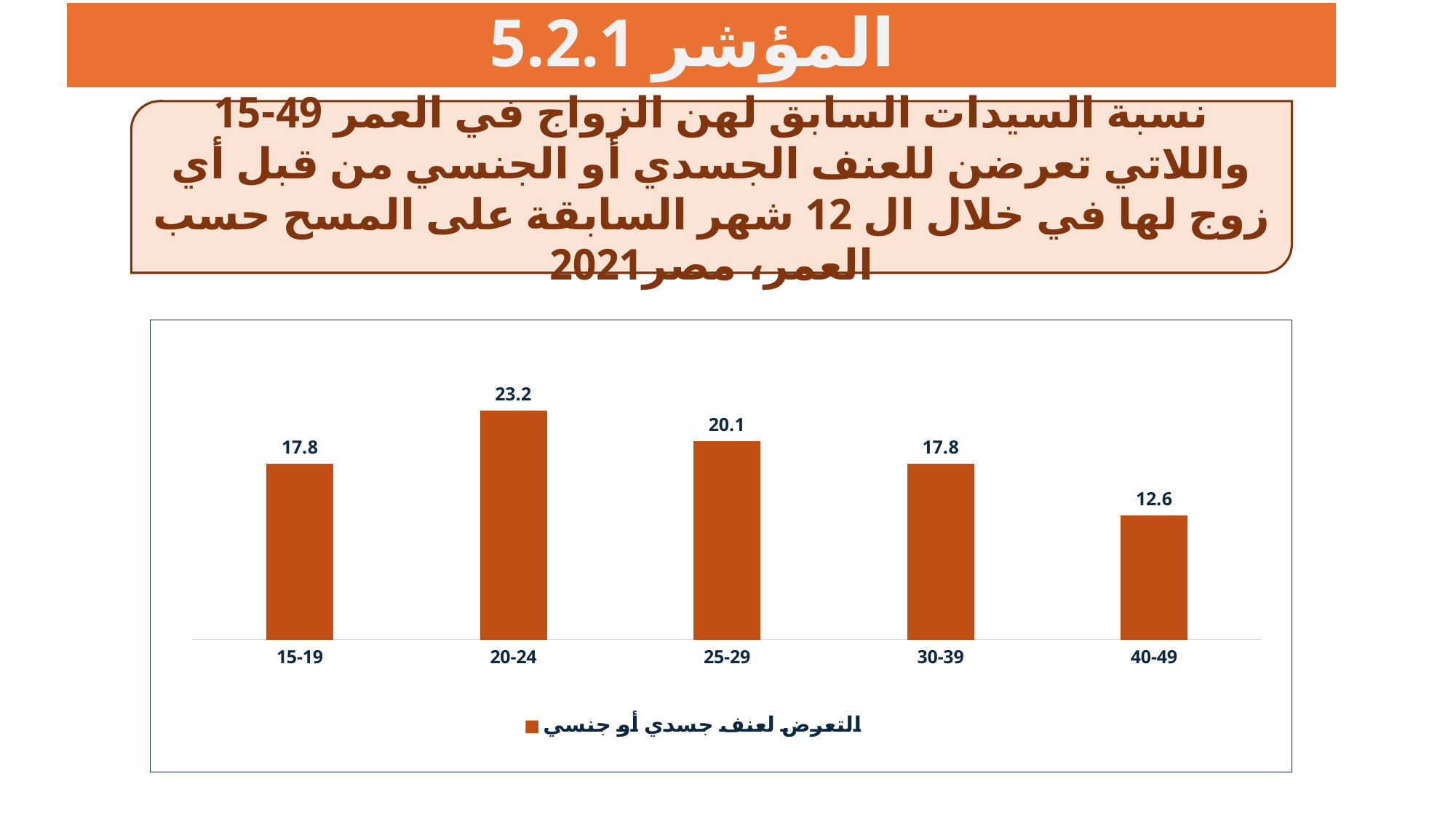
What is the value for the 25-29 age group? 20.1 Which age group has the highest value? 20-24 What is the difference between the values for 25-29 and 30-39? 2.3 What is the value for the 20-24 age group? 23.2 How many age groups are shown on the x axis? 5 Which two age groups have the same value of 17.8? 15-19 and 30-39 How many series does the legend list? 1 Which is larger, the value for 25-29 or the value for 30-39? 25-29 What kind of chart is shown on the slide? bar chart What is the value for the 40-49 age group? 12.6 Which age group has the lowest value? 40-49 What is the difference between the values for 20-24 and 40-49? 10.6